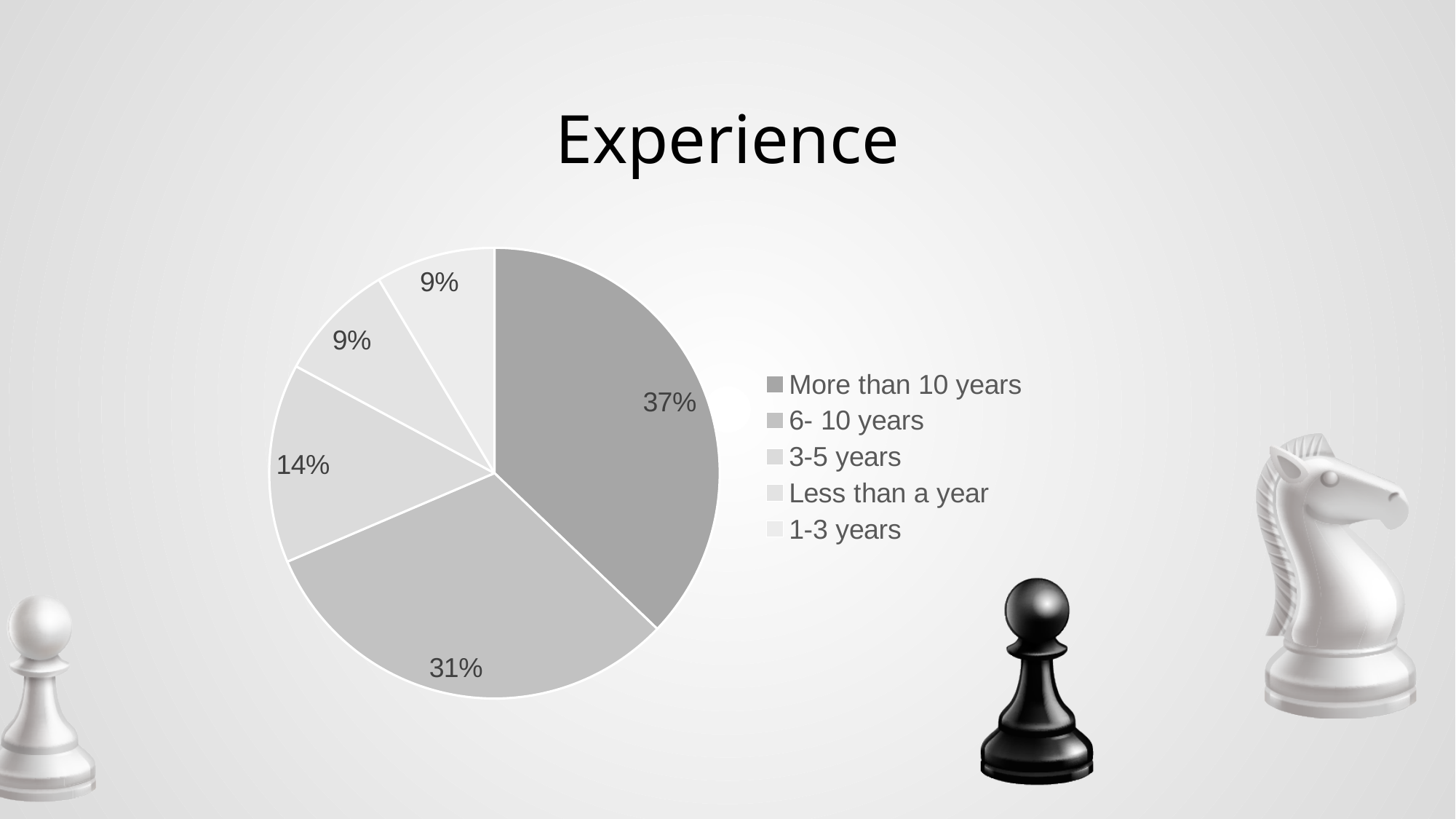
Which legend entry is listed first? More than 10 years What is the difference in percentage points between '3-5 years' and 'Less than a year'? 5 Which category has the largest slice of the pie? More than 10 years What share of the pie is labelled for '3-5 years'? 14% What is the title of the chart? Experience What share of the pie is labelled for '6- 10 years'? 31% What share of the pie is labelled for 'More than 10 years'? 37% What is the difference in percentage points between 'More than 10 years' and '6- 10 years'? 6 What kind of chart is shown on the slide? pie chart Which is larger, the slice for '3-5 years' or the slice for '1-3 years'? 3-5 years How many categories does the legend list? 5